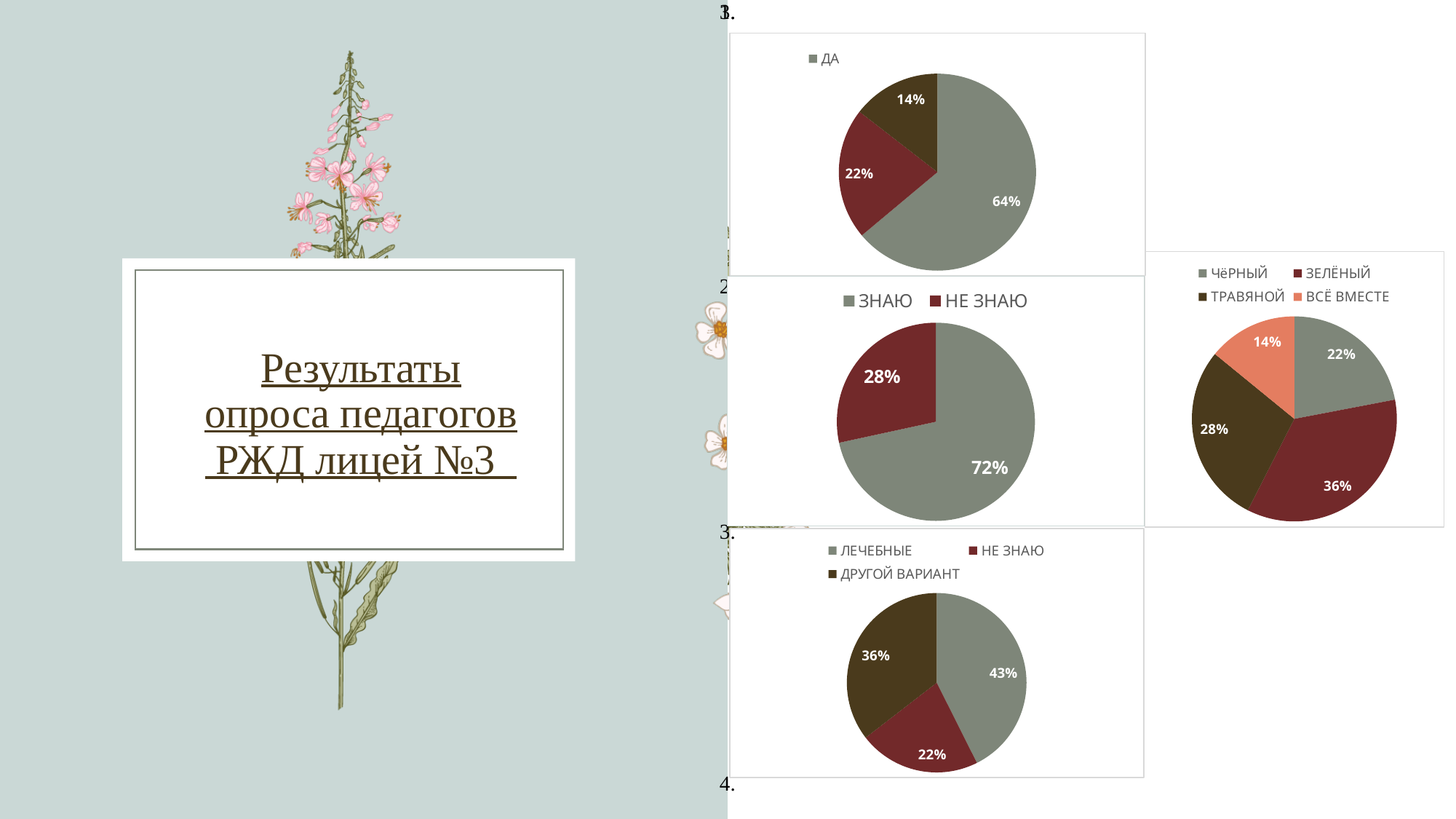
In the pie chart on the far right, what share is ВСЁ ВМЕСТЕ? 14% In the pie chart on the far right, which category has the largest share? ЗЕЛЁНЫЙ In the bottom pie chart, which is larger: ДРУГОЙ ВАРИАНТ or НЕ ЗНАЮ? ДРУГОЙ ВАРИАНТ How many categories does the legend of the pie chart on the far right list? 4 In the pie chart on the far right, which category has the smallest share? ВСЁ ВМЕСТЕ In the pie chart on the far right, what is the difference between the shares of ТРАВЯНОЙ and ЧёРНЫЙ? 6% What type of chart is the top chart in the right column? Pie chart In the pie chart with the legend ЗНАЮ / НЕ ЗНАЮ, what share is НЕ ЗНАЮ? 28% How many series does the legend of the pie chart with ЗНАЮ / НЕ ЗНАЮ list? 2 In the pie chart with the legend ЗНАЮ / НЕ ЗНАЮ (middle of the right column), what share is ЗНАЮ? 72% In the bottom pie chart (ЛЕЧЕБНЫЕ, НЕ ЗНАЮ, ДРУГОЙ ВАРИАНТ), what share is ЛЕЧЕБНЫЕ? 43% In the pie chart on the far right (ЧёРНЫЙ, ЗЕЛЁНЫЙ, ТРАВЯНОЙ, ВСЁ ВМЕСТЕ), what share is ЗЕЛЁНЫЙ? 36%